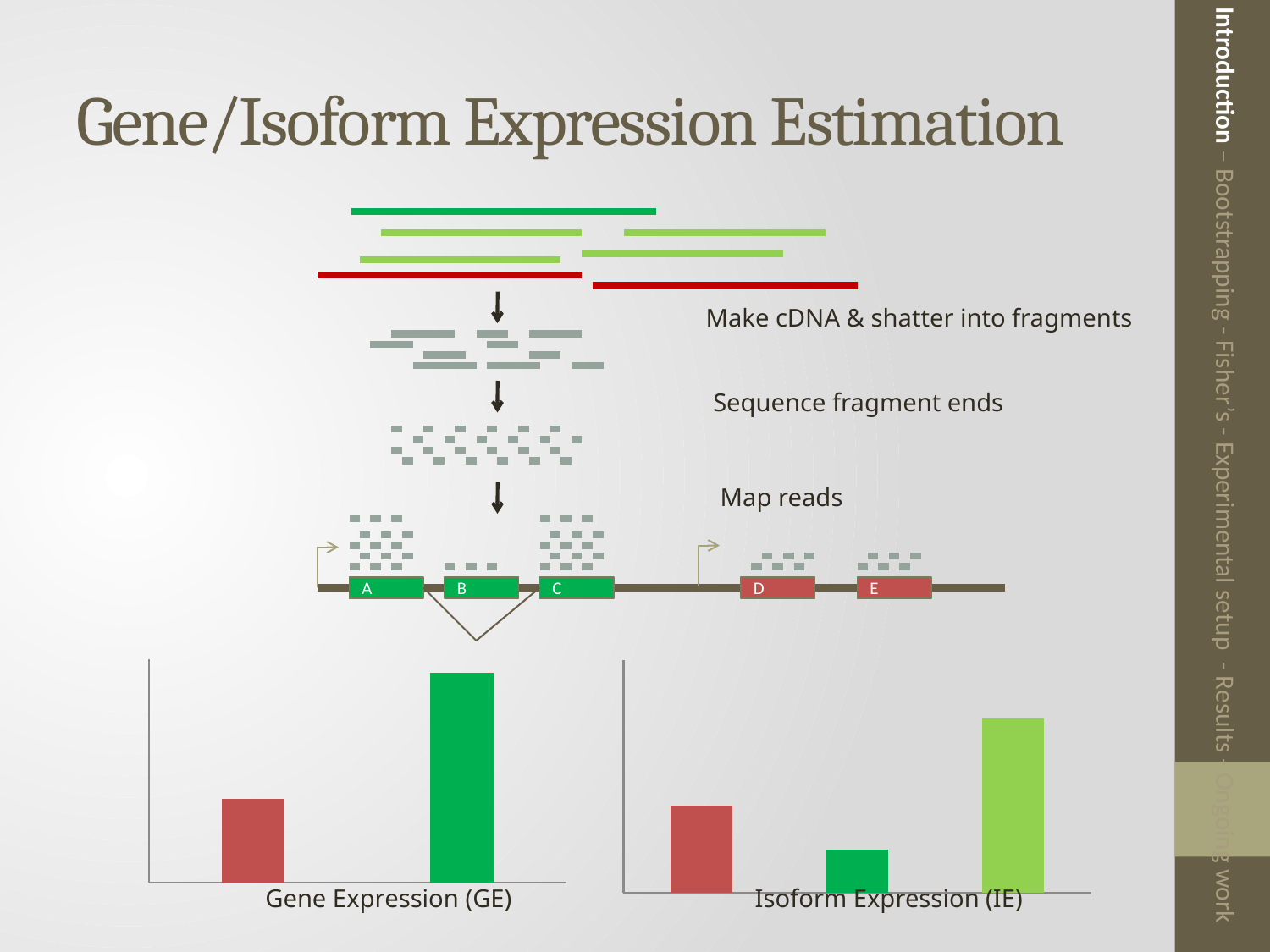
What is the title of the bar chart on the right of the slide? Isoform Expression (IE) In the "Isoform Expression (IE)" chart, which bar is taller, the red bar or the dark green bar? the red bar In the "Gene Expression (GE)" chart, which bar is the shortest? the red bar (left) In the "Isoform Expression (IE)" chart, which bar is the shortest? the dark green bar (middle) What kind of chart is the "Gene Expression (GE)" chart? bar chart How many bars are in the "Isoform Expression (IE)" chart? 3 In the "Isoform Expression (IE)" chart, which bar is the tallest? the light green bar (rightmost) How many bars are in the "Gene Expression (GE)" chart? 2 What is the title of the bar chart on the left of the slide? Gene Expression (GE) How many bar charts are shown on the slide? 2 In the "Gene Expression (GE)" chart, which bar is taller, the red bar or the green bar? the green bar What kind of chart is the "Isoform Expression (IE)" chart? bar chart